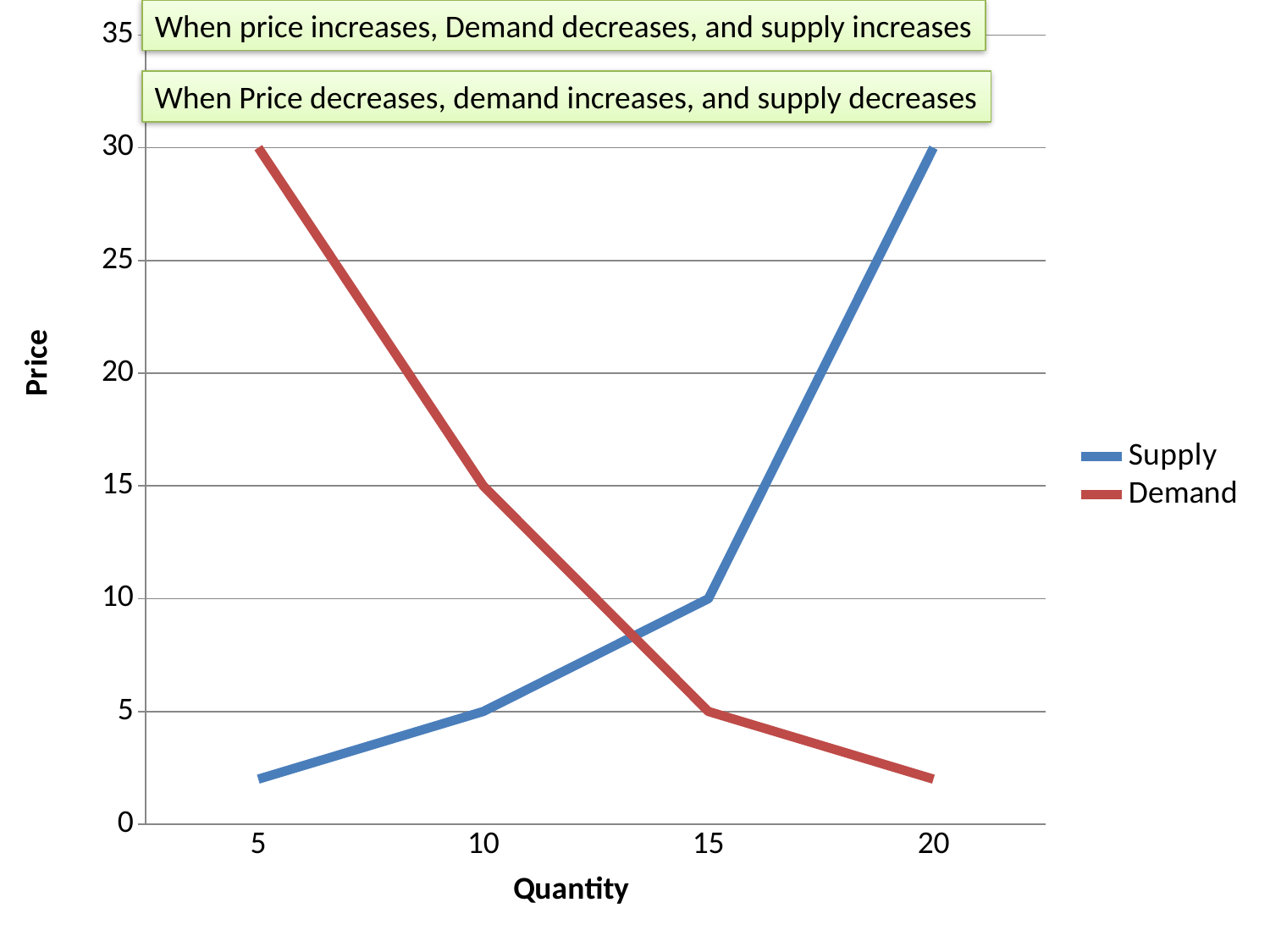
What kind of chart is shown on the slide? line chart At a quantity of 10, which line shows the higher price, Supply or Demand? Demand What is the price on the Supply line at a quantity of 20? 30 What is the price on the Demand line at a quantity of 10? 15 What is the price on the Demand line at a quantity of 5? 30 What is the price on the Supply line at a quantity of 15? 10 Is the Supply price at a quantity of 5 greater or less than 5? less Does the Supply line rise or fall as quantity increases? rises Does the Demand line rise or fall as quantity increases? falls How many quantity points are plotted along the x axis? 4 What is the difference between the Supply price at quantity 20 and the Supply price at quantity 15? 20 How many series does the legend list? 2